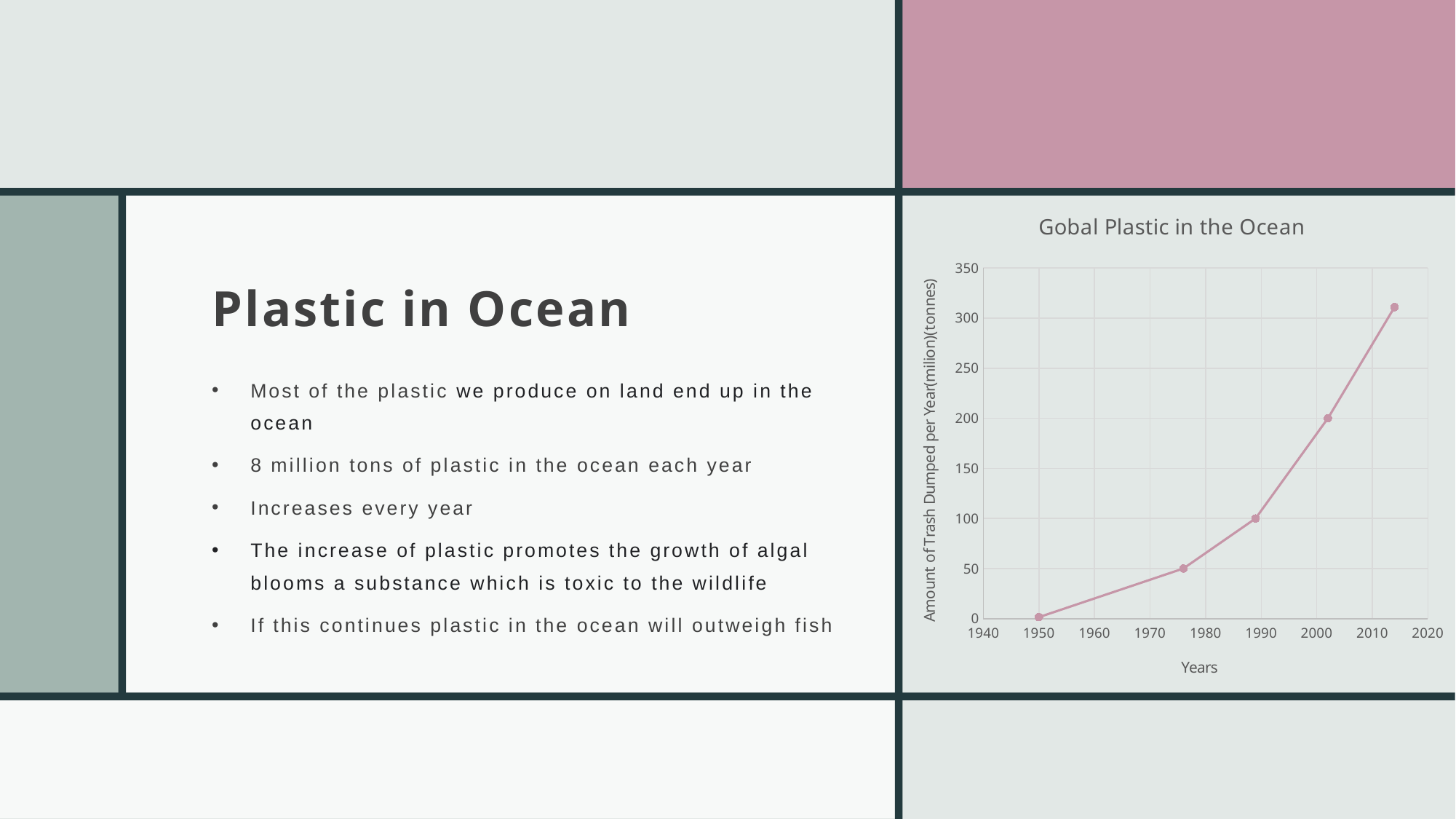
Is the value of the data point around 1976 greater or less than 100? less Is the value of the data point around 1989 greater or less than 150? less Is the value of the rightmost data point (around 2014) greater or less than 300? greater Which data point has the highest value, the one around 1950 or the one around 2014? the one around 2014 What is the highest value shown on the y axis of the chart? 350 How many data points are plotted on the chart? 5 What is the title of the chart? Gobal Plastic in the Ocean Do the values on the chart rise or fall as the years increase? rise What is the label of the x axis of the chart? Years What kind of chart is shown on the slide? line chart